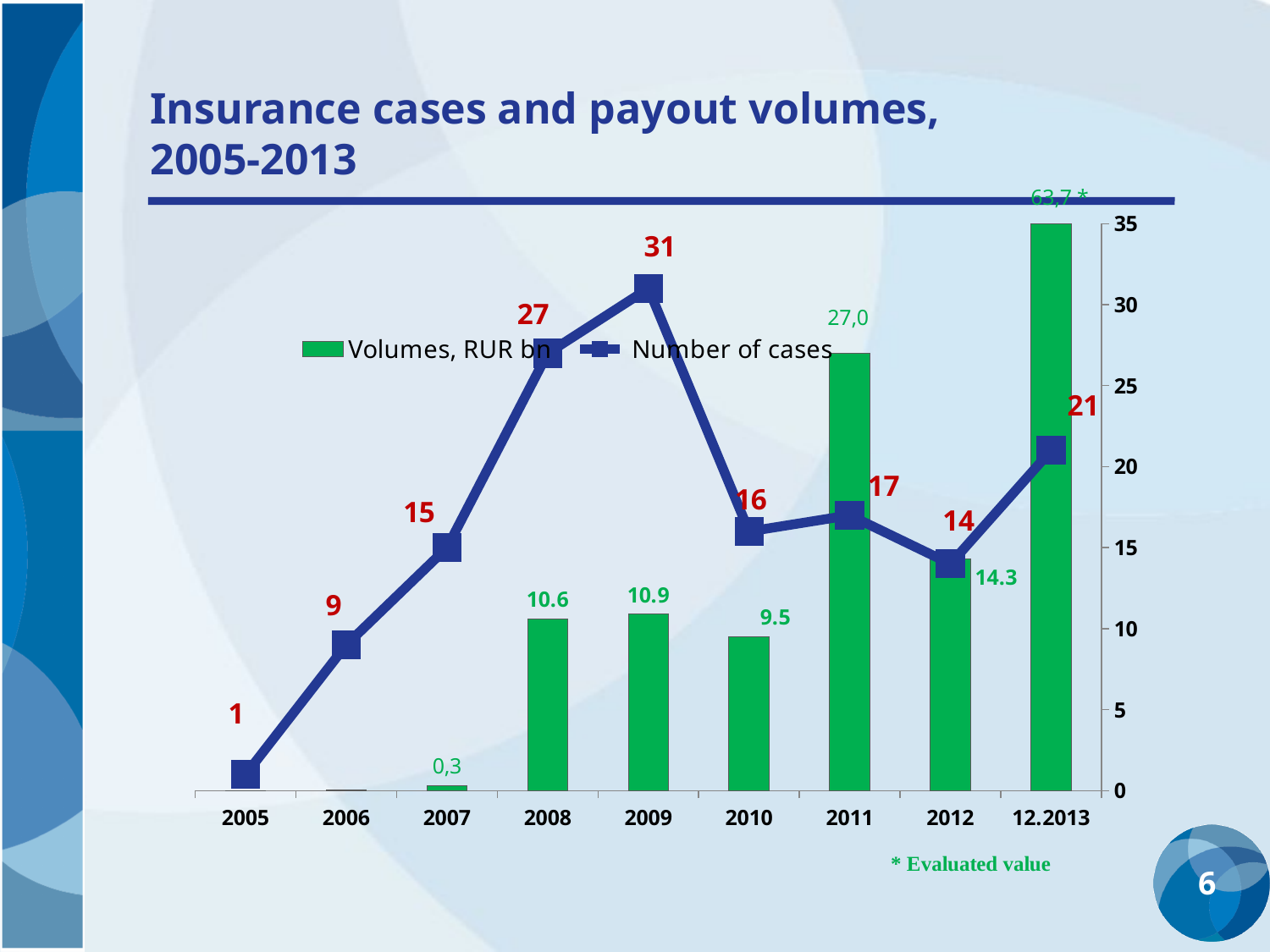
How many series does the legend list? 2 What does the asterisk next to the 12.2013 volume value indicate? Evaluated value In which year is the number of cases highest? 2009 Which year has the larger volume, 2010 or 2012? 2012 Does the number of cases rise or fall from 2005 to 2009? rise In which year is the number of cases lowest? 2005 How many categories are shown on the x axis? 9 What is the difference in the number of cases between 2009 and 2010? 15 What is the value of Volumes, RUR bn for 2008? 10.6 What is the number of cases in 2009? 31 What is the value of Volumes, RUR bn for 2011? 27,0 What is the number of cases in 12.2013? 21